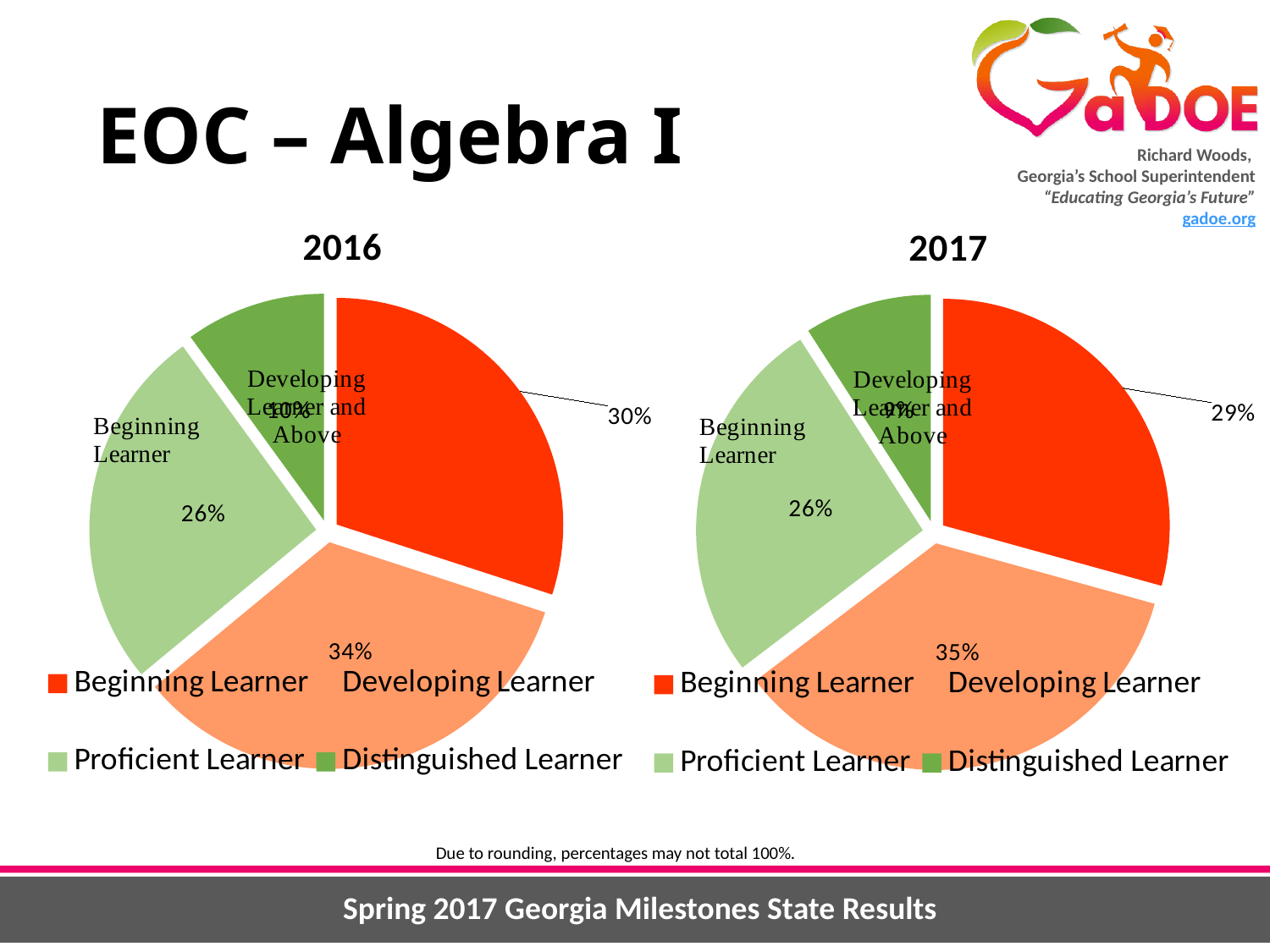
In the 2017 pie chart, which is larger: Developing Learner or Proficient Learner? Developing Learner In the 2016 pie chart, how many percentage points larger is Developing Learner than Beginning Learner? 4 percentage points In the 2016 pie chart, what percentage is shown for Developing Learner? 34% In the 2016 pie chart, what colour is the Beginning Learner slice? Red In the 2016 pie chart, what percentage is shown for Proficient Learner? 26% In the 2017 pie chart, what percentage is shown for Beginning Learner? 29% In the 2017 pie chart, what percentage is shown for Developing Learner? 35% In the 2016 pie chart, what percentage is shown for Beginning Learner? 30% What type of chart is used to show the 2016 and 2017 results? Pie chart In the 2016 pie chart, which category has the largest share? Developing Learner In the 2017 pie chart, which category has the smallest share? Distinguished Learner How many categories does the legend of the 2017 chart list? 4